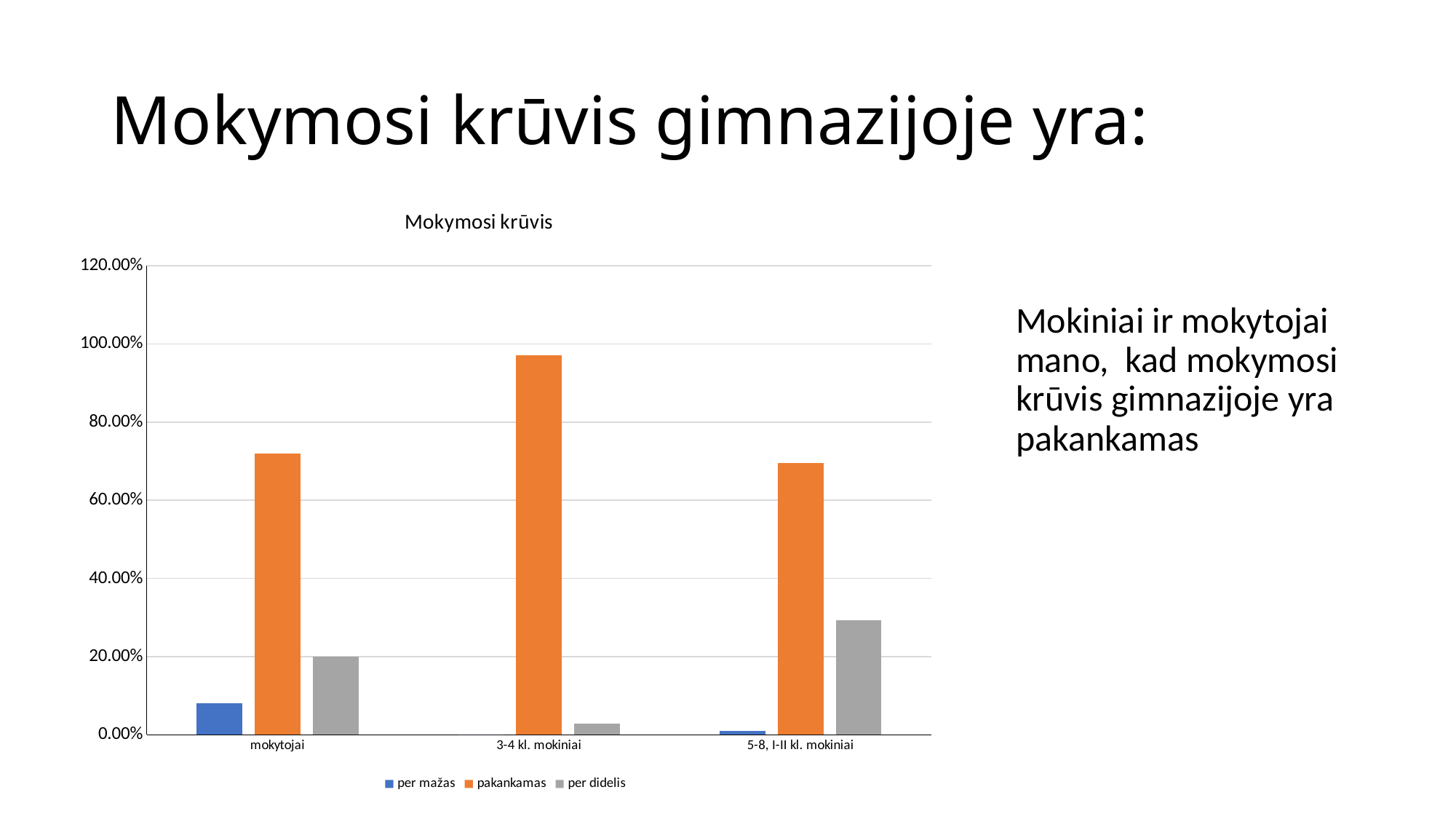
Which category has the highest value for the 'pakankamas' series? 3-4 kl. mokiniai Is the 'per didelis' value for '5-8, I-II kl. mokiniai' greater or less than 20.00%? greater How many categories are shown on the x axis of the chart? 3 Which is larger: the 'per mažas' value for 'mokytojai' or for '5-8, I-II kl. mokiniai'? mokytojai For the 'mokytojai' category, which series has the highest value? pakankamas How many series does the chart legend list? 3 Which category has the lowest value for the 'per didelis' series? 3-4 kl. mokiniai Which series is represented by the orange bars in the chart? pakankamas Which category has the highest value for the 'per didelis' series? 5-8, I-II kl. mokiniai What kind of chart is shown on the slide? bar chart Is the 'pakankamas' value for '3-4 kl. mokiniai' greater or less than 80.00%? greater What is the title of the chart? Mokymosi krūvis